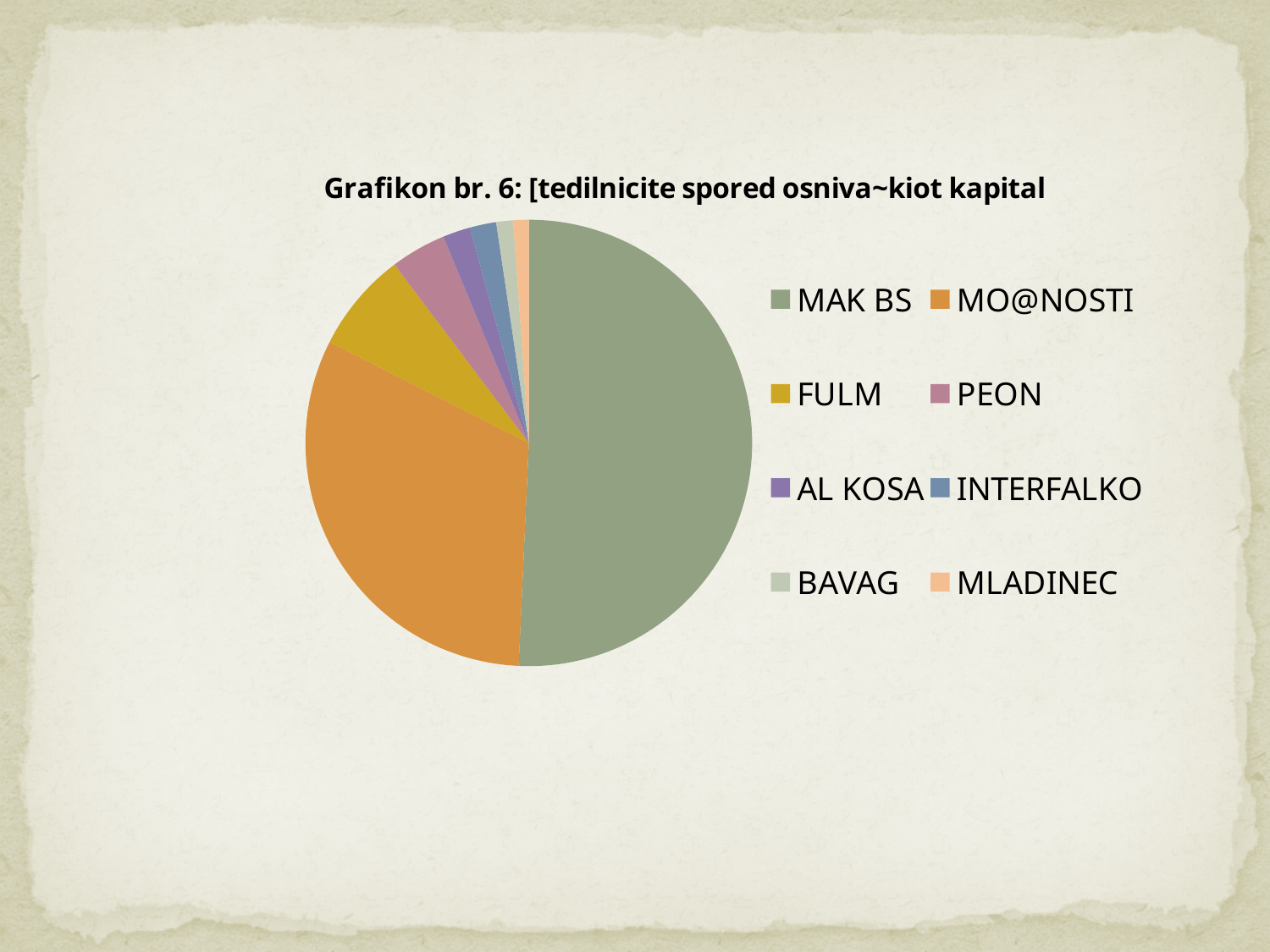
Which slice is larger, MAK BS or MO@NOSTI? MAK BS Which slice is larger, MO@NOSTI or FULM? MO@NOSTI Which slice is larger, FULM or AL KOSA? FULM How many slices does the pie chart have? 8 What kind of chart is shown on the slide? Pie chart How many entries does the legend list? 8 Which category has the largest slice of the pie? MAK BS Which category is shown in orange in the legend, listed second? MO@NOSTI What is the title of the chart? Grafikon br. 6: [tedilnicite spored osniva~kiot kapital